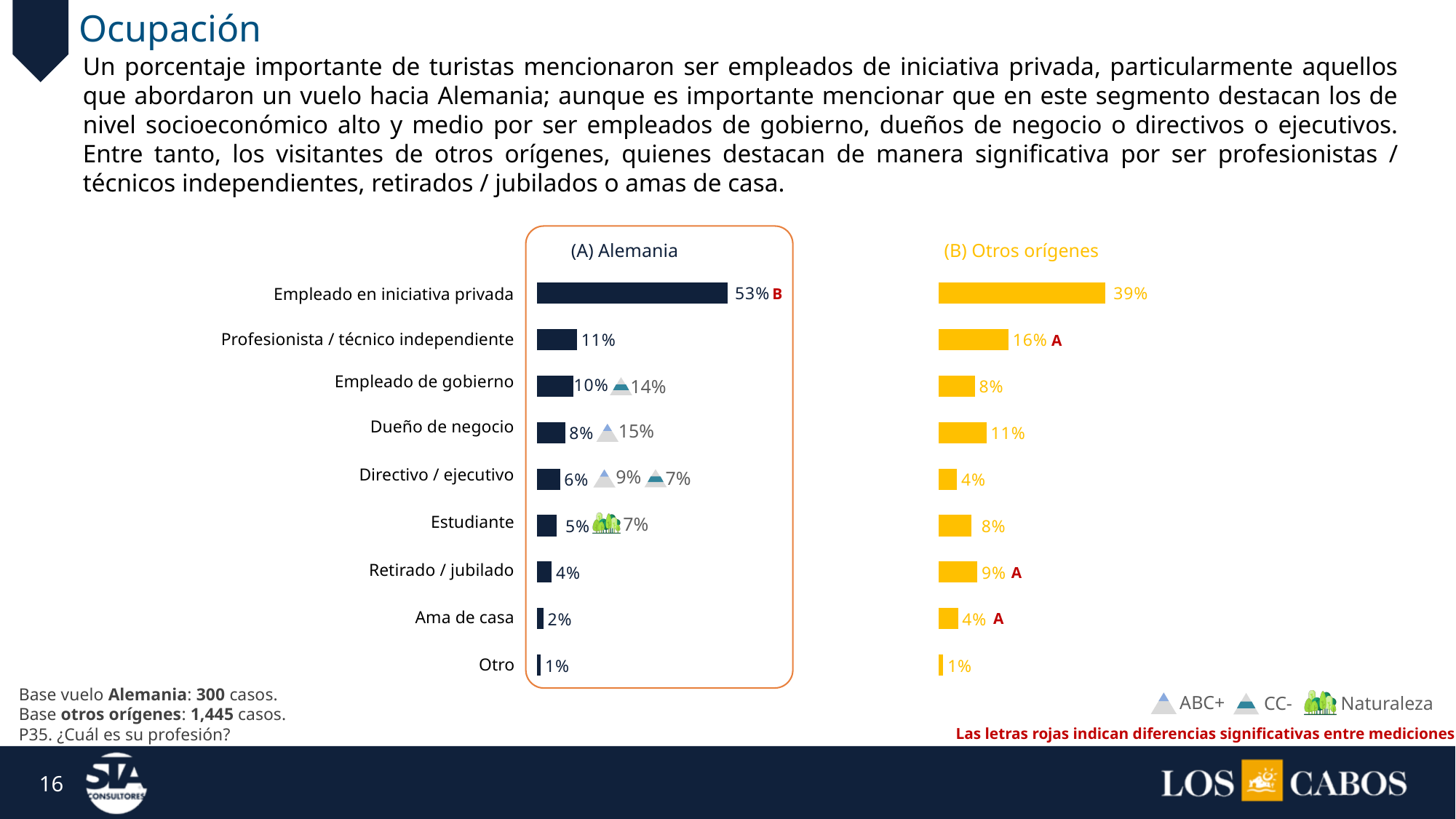
What is the difference between the Empleado en iniciativa privada value in the (A) Alemania chart and in the (B) Otros orígenes chart? 14 percentage points In the (B) Otros orígenes chart, what is the value for Estudiante? 8% In the (B) Otros orígenes chart, what is the value for Profesionista / técnico independiente? 16% In the (A) Alemania chart, what is the value for Empleado en iniciativa privada? 53% For Dueño de negocio, which chart shows the larger value, (A) Alemania or (B) Otros orígenes? (B) Otros orígenes In the (B) Otros orígenes chart, what is the difference between Retirado / jubilado and Ama de casa? 5 percentage points According to the note below the charts, how many cases form the base for vuelo Alemania? 300 casos In the (A) Alemania chart, which category has the lowest value? Otro In the (B) Otros orígenes chart, which category has the highest value? Empleado en iniciativa privada What kind of chart is the (B) Otros orígenes chart? Bar chart In the (A) Alemania chart, what is the value for Retirado / jubilado? 4% How many occupation categories are shown in the (A) Alemania chart? 9